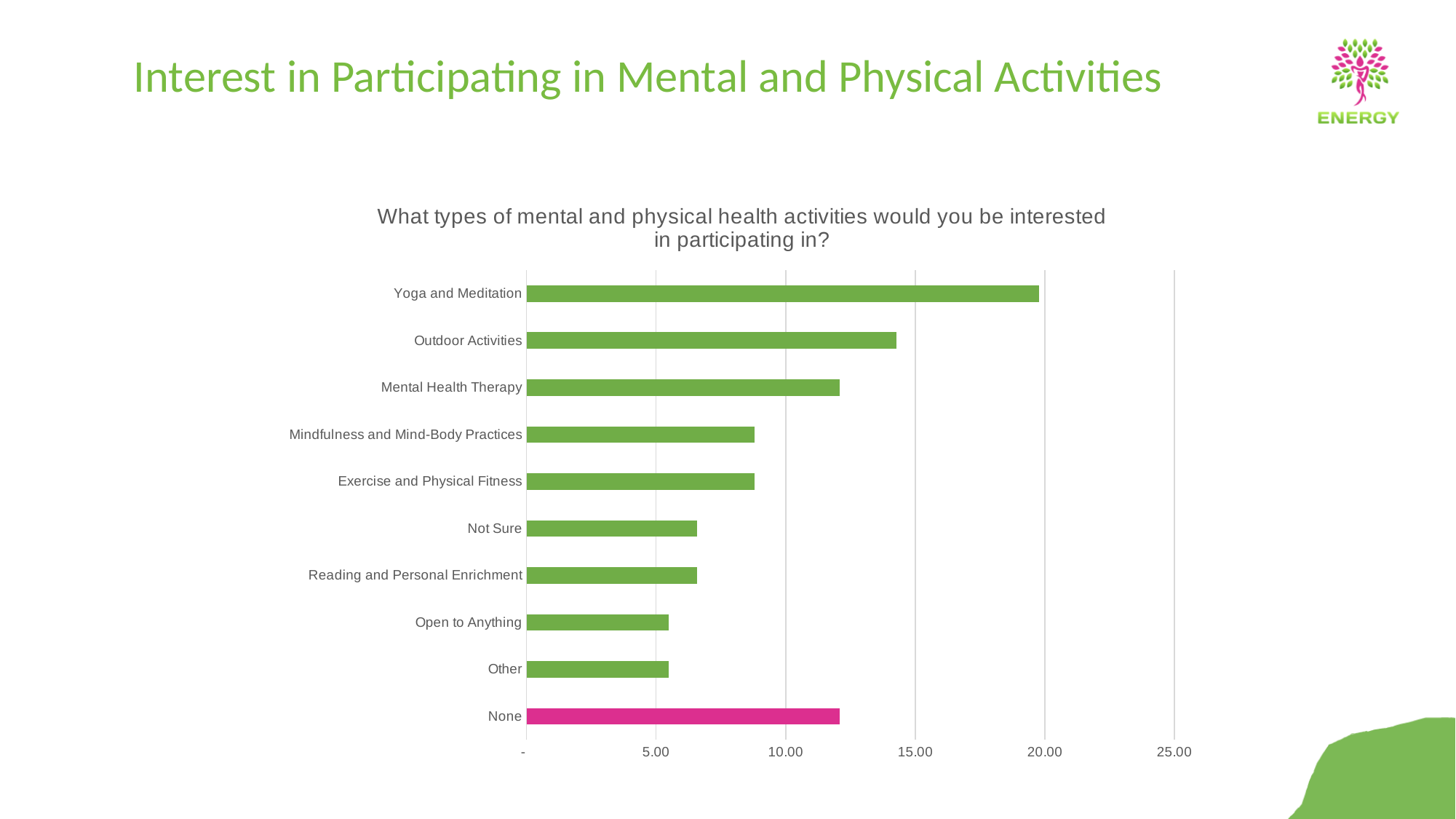
What kind of chart is shown on the slide? Bar chart How many categories are plotted in the chart? 10 Is the value for Not Sure greater or less than 5.00? greater Which is larger, the value for Outdoor Activities or the value for Mental Health Therapy? Outdoor Activities Which is larger, the value for Yoga and Meditation or the value for Outdoor Activities? Yoga and Meditation Is the value for Outdoor Activities greater or less than 15.00? less Which category has the highest value in the chart? Yoga and Meditation Is the value for Yoga and Meditation greater or less than 15.00? greater Which category's bar is shown in a different colour (pink) from the others? None